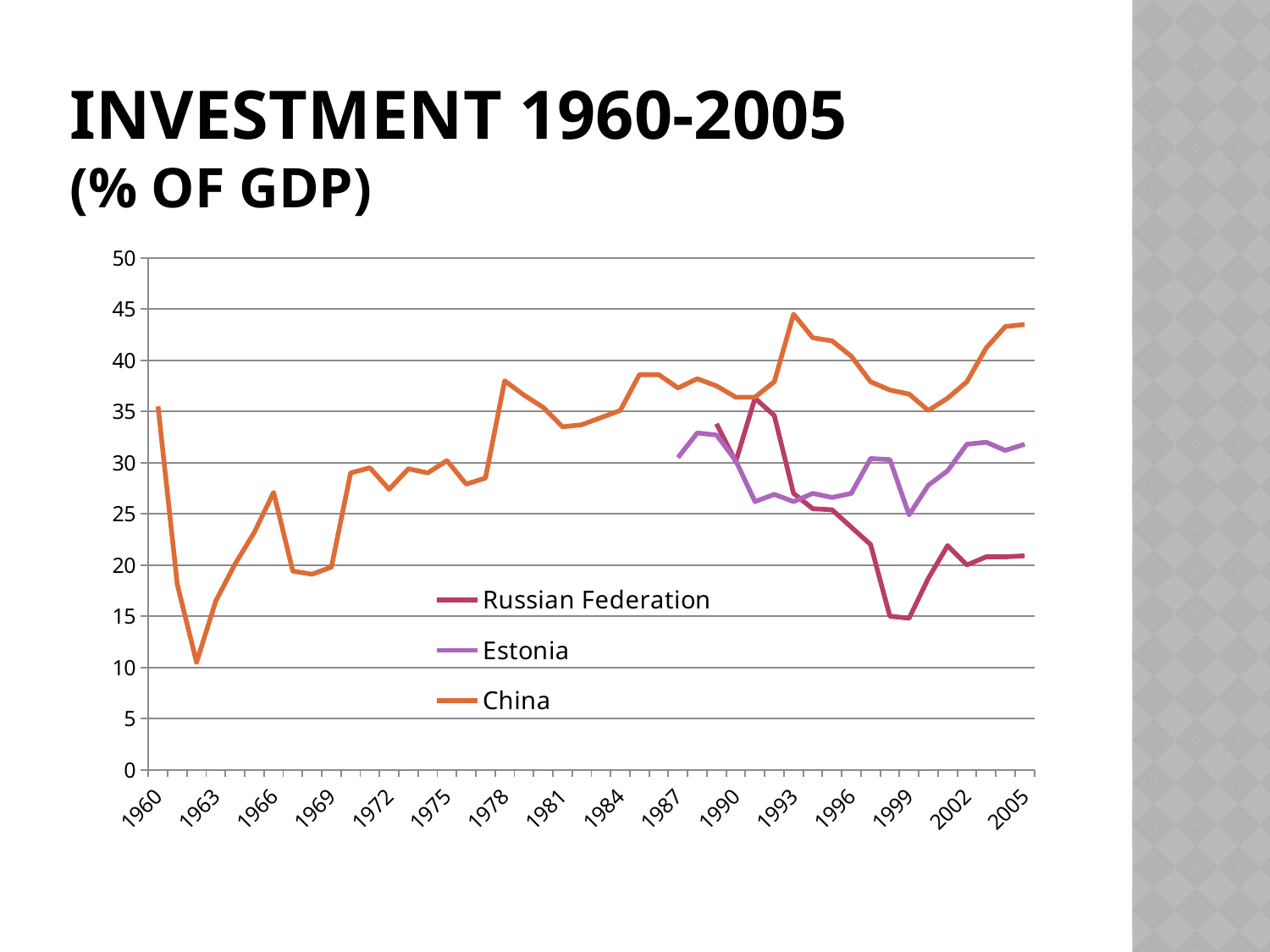
Is the value for the Russian Federation in 1999 greater or less than 20? less Is the value for China in 1962 greater or less than 15? less Is the value for China in 1993 greater or less than 40? greater What kind of chart is shown on the slide? line chart In 1999, which is larger: the value for Estonia or the value for the Russian Federation? Estonia Which series is drawn in orange? China Which series has the lowest value in 2005? Russian Federation Does the Russian Federation line rise or fall between 1991 and 1999? fall How many series does the legend list? 3 Which series has the highest value in 2005? China What is the title of the chart on the slide? Investment 1960-2005 (% of GDP)